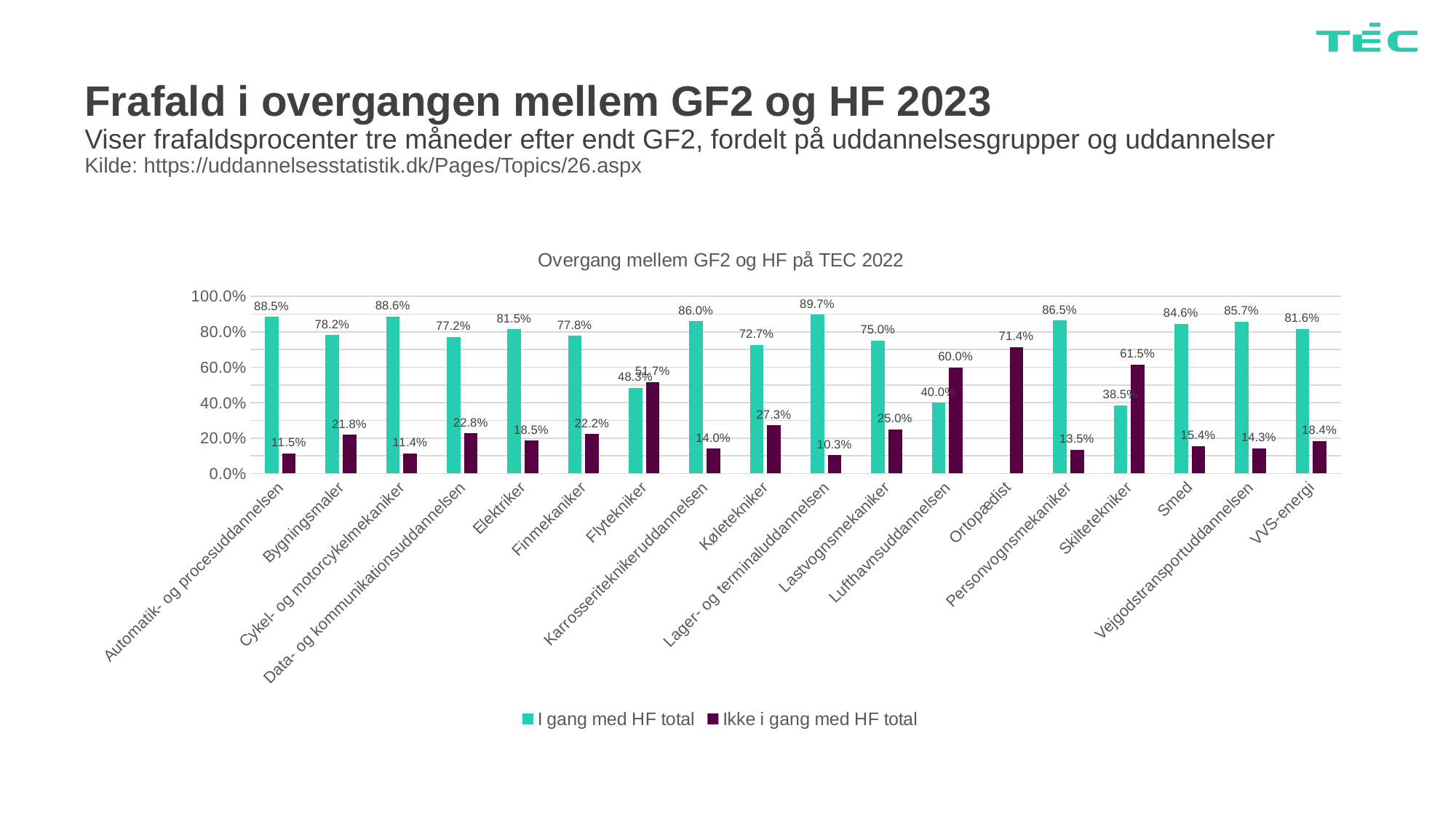
What is the value of "I gang med HF total" for Elektriker? 81.5% Is the "I gang med HF total" value for Lufthavnsuddannelsen greater or less than 60.0%? less Which is larger for Flytekniker: "I gang med HF total" or "Ikke i gang med HF total"? Ikke i gang med HF total What is the value of "Ikke i gang med HF total" for Ortopædist? 71.4% How many categories are shown on the x axis? 18 What is the value of "Ikke i gang med HF total" for Skiltetekniker? 61.5% Which category has the highest value for "Ikke i gang med HF total"? Ortopædist What type of chart is shown on the slide? Bar chart Which category has the lowest value for "Ikke i gang med HF total"? Lager- og terminaluddannelsen What is the difference between the "I gang med HF total" values for Cykel- og motorcykelmekaniker and Bygningsmaler? 10.4% Which category has the highest value for "I gang med HF total"? Lager- og terminaluddannelsen How many series does the legend list? 2